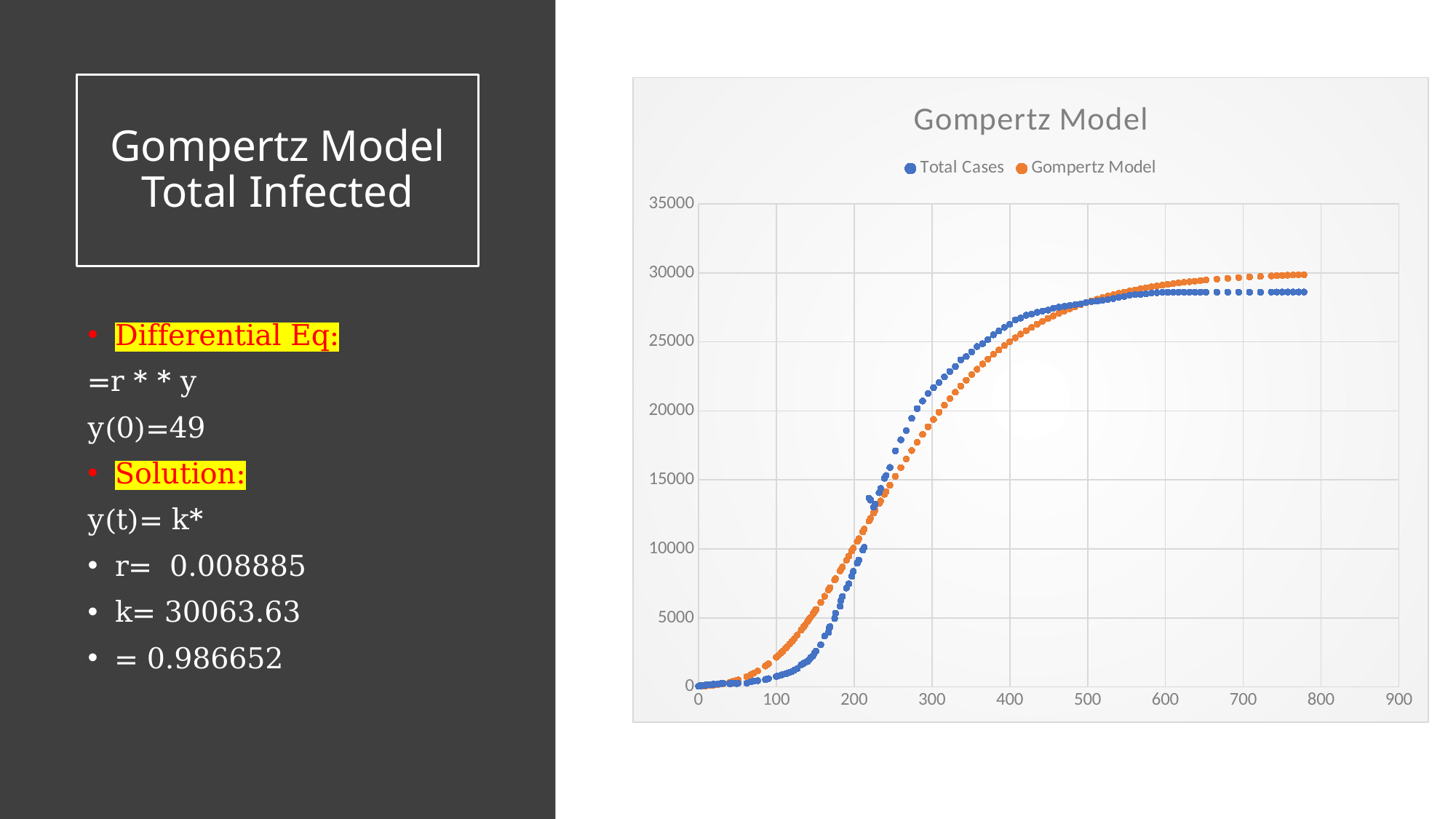
Do the Total Cases values rise or fall as the x axis increases? rise Is the Gompertz Model value at x = 100 greater or less than 5000? less At x = 750, which series has the higher value, Total Cases or Gompertz Model? Gompertz Model What kind of chart is shown on the slide? scatter chart What is the title of the chart? Gompertz Model Is the Gompertz Model value at x = 400 greater or less than 20000? greater How many series does the legend of the chart list? 2 Which colour represents the Total Cases series in the chart? blue At x = 300, which series has the higher value, Total Cases or Gompertz Model? Total Cases Is the Total Cases value at x = 150 greater or less than 5000? less At x = 100, which series has the higher value, Total Cases or Gompertz Model? Gompertz Model